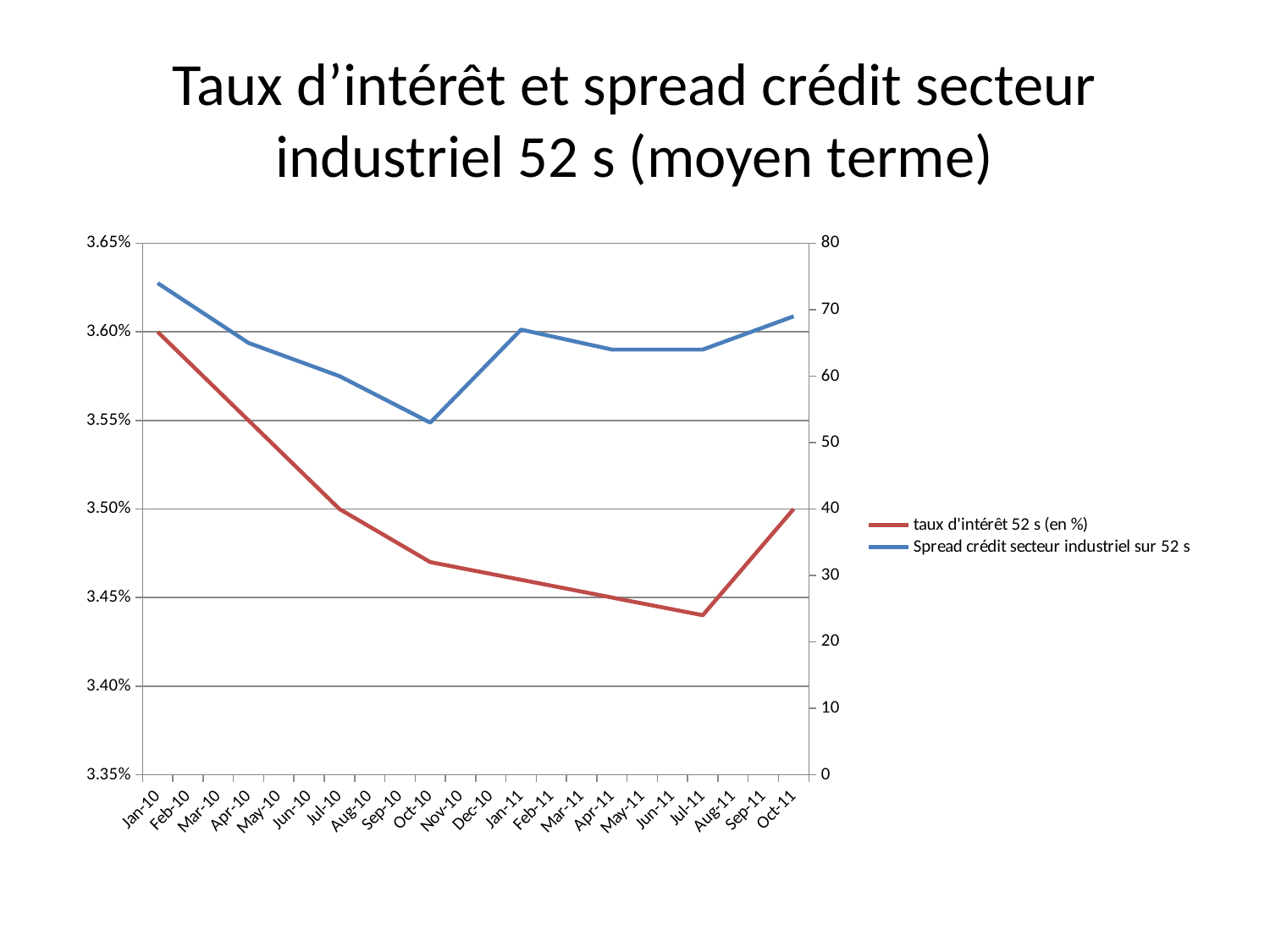
In which month is 'taux d'intérêt 52 s (en %)' at its lowest? Jul-11 What colour is the line for 'Spread crédit secteur industriel sur 52 s'? blue What is the value of 'taux d'intérêt 52 s (en %)' in Jul-10? 3.50% In which month is 'Spread crédit secteur industriel sur 52 s' at its lowest? Oct-10 What type of chart is shown on the slide? line chart What is the value of 'taux d'intérêt 52 s (en %)' in Jan-10? 3.60% How many series does the legend list? 2 Is the value of 'Spread crédit secteur industriel sur 52 s' in Oct-10 greater or less than 60? less In which month is 'Spread crédit secteur industriel sur 52 s' at its highest? Jan-10 What is the value of 'taux d'intérêt 52 s (en %)' in Oct-11? 3.50% How many month labels are shown on the x axis? 22 Does 'taux d'intérêt 52 s (en %)' rise or fall from Jan-10 to Jul-11? fall